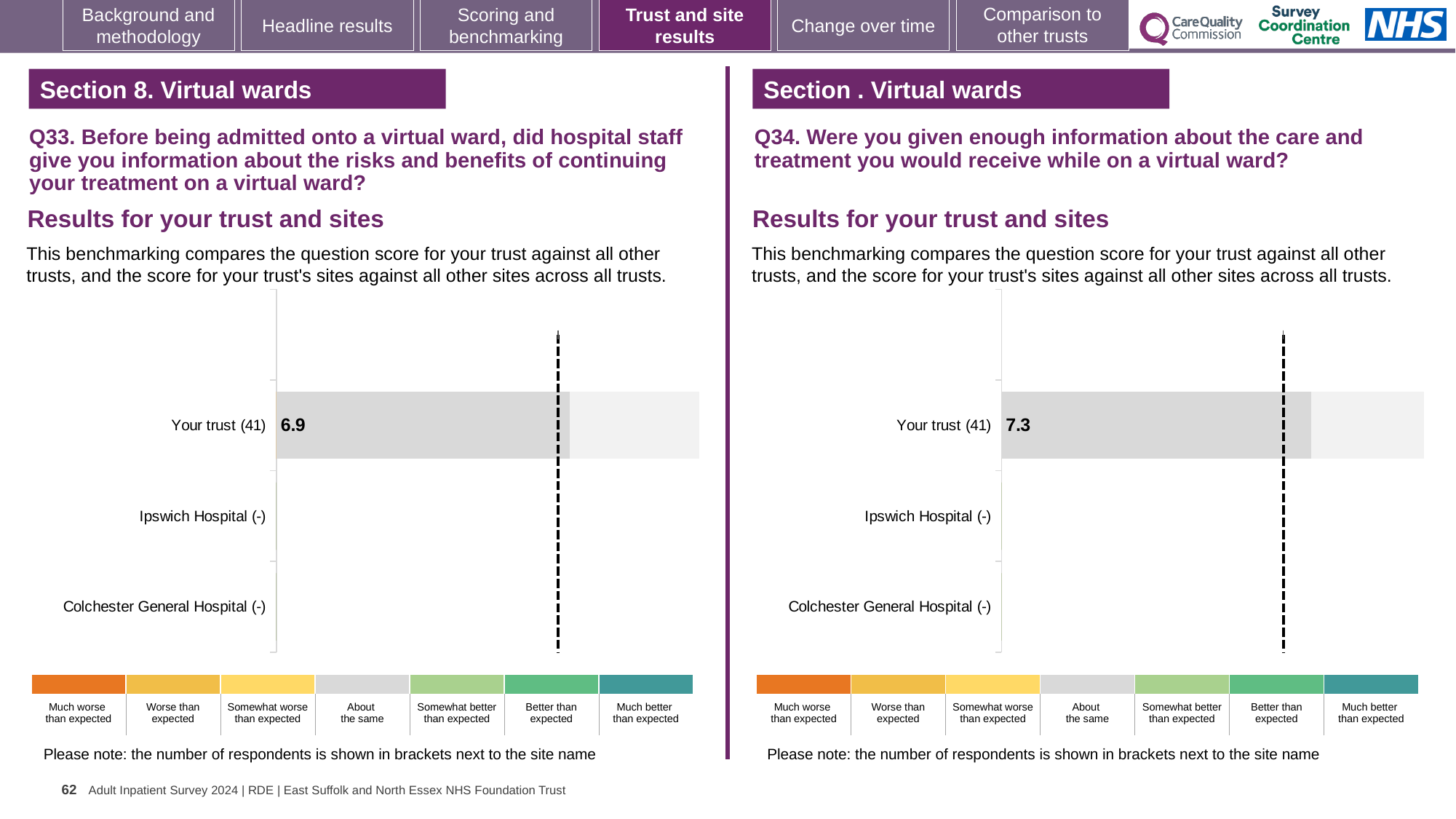
Comparing the Your trust scores, which chart shows the higher value: the left chart (Q33) or the right chart (Q34)? the right chart (Q34) On the right chart (Q34), what is the score for Your trust? 7.3 What is the difference between the Your trust score on the right chart (Q34) and the Your trust score on the left chart (Q33)? 0.4 On the right chart (Q34), how many categories in the colour key below the chart describe the benchmark bands? 7 On the right chart (Q34), how many respondents are shown in brackets next to Your trust? 41 On the left chart (Q33), which category has a plotted bar with a printed value? Your trust (41) On the left chart (Q33), how many respondents are shown in brackets next to Your trust? 41 On the right chart (Q34), how many categories are listed on the vertical axis? 3 What kind of chart is used on the left chart (Q33)? bar chart On the left chart (Q33), what is the score for Your trust? 6.9 On the left chart (Q33), how many categories are listed on the vertical axis? 3